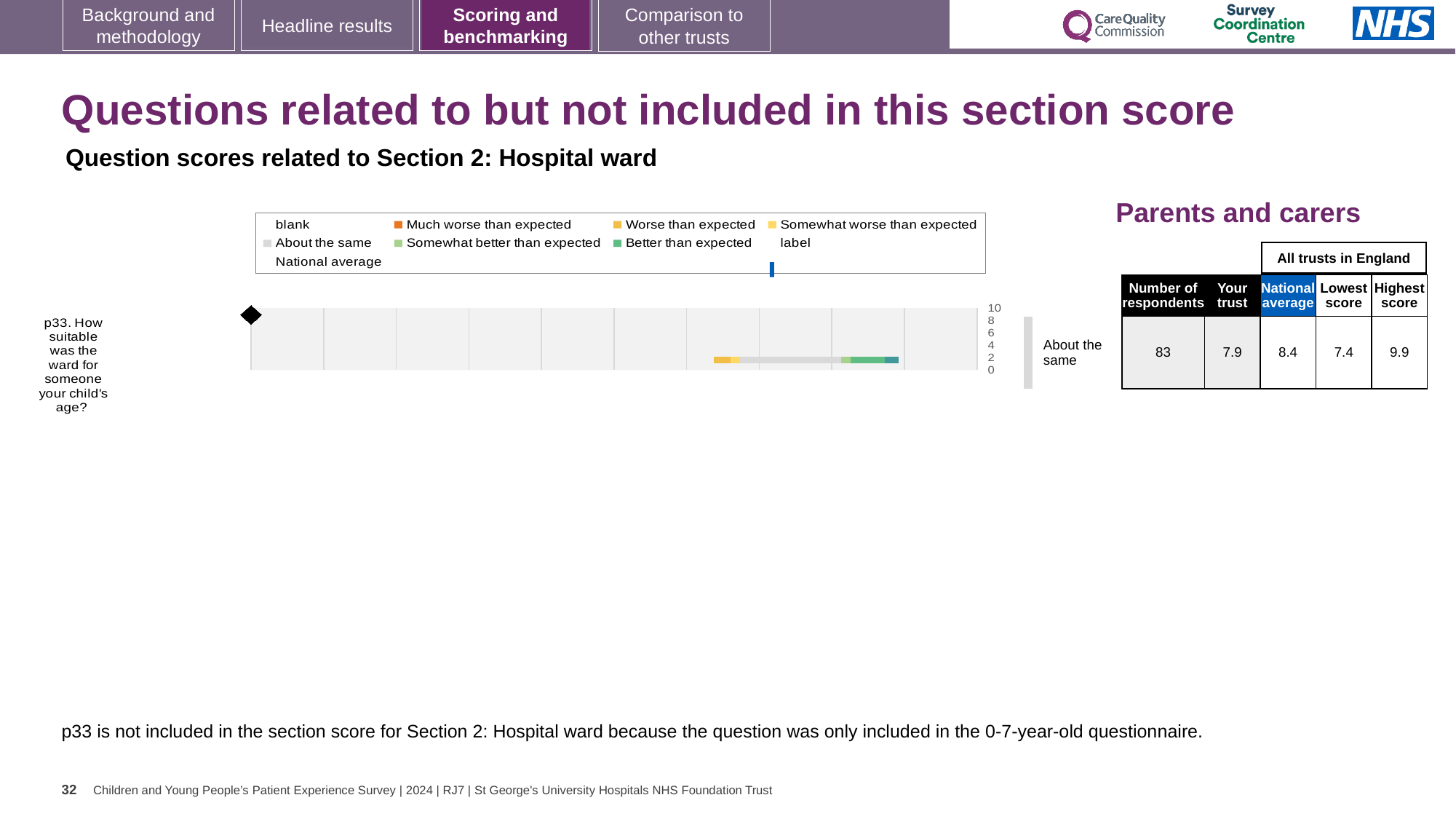
Which question is plotted on the chart? p33. How suitable was the ward for someone your child's age? How many question categories are plotted on the chart? 1 What is the difference between the national average and the trust score for p33? 0.5 What is the highest value shown on the chart's axis? 10 What is the 'Your trust' score for p33? 7.9 Which is larger for p33, the trust score or the national average? national average What is the national average score for p33? 8.4 What kind of chart is shown for question p33? bar chart What benchmark category is the trust's p33 score placed in? About the same What is the highest score among all trusts in England for p33? 9.9 What is the lowest score among all trusts in England for p33? 7.4 How many respondents answered p33? 83